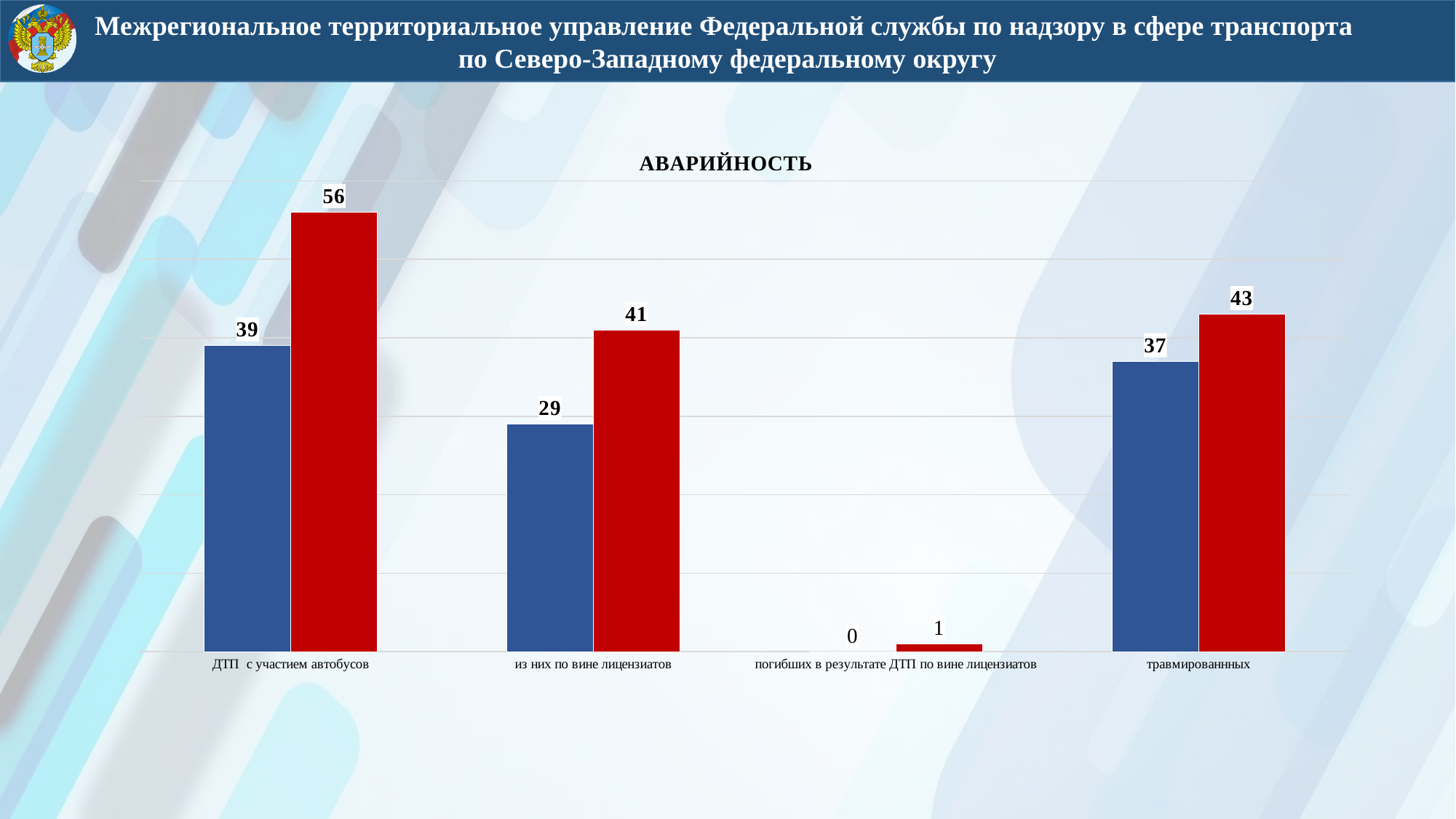
What is the value of the red bar for "травмированнных"? 43 What type of chart is shown on the slide? bar chart How many categories are shown on the x axis? 4 What is the value of the red bar for "ДТП с участием автобусов"? 56 What is the difference between the red and blue bars for "ДТП с участием автобусов"? 17 What is the value of the blue bar for "из них по вине лицензиатов"? 29 Which category has the lowest blue bar? погибших в результате ДТП по вине лицензиатов What is the difference between the red and blue bars for "из них по вине лицензиатов"? 12 What is the value of the blue bar for "ДТП с участием автобусов"? 39 What is the value of the red bar for "погибших в результате ДТП по вине лицензиатов"? 1 Which category has the highest red bar? ДТП с участием автобусов Which is larger for "травмированнных": the blue bar or the red bar? the red bar